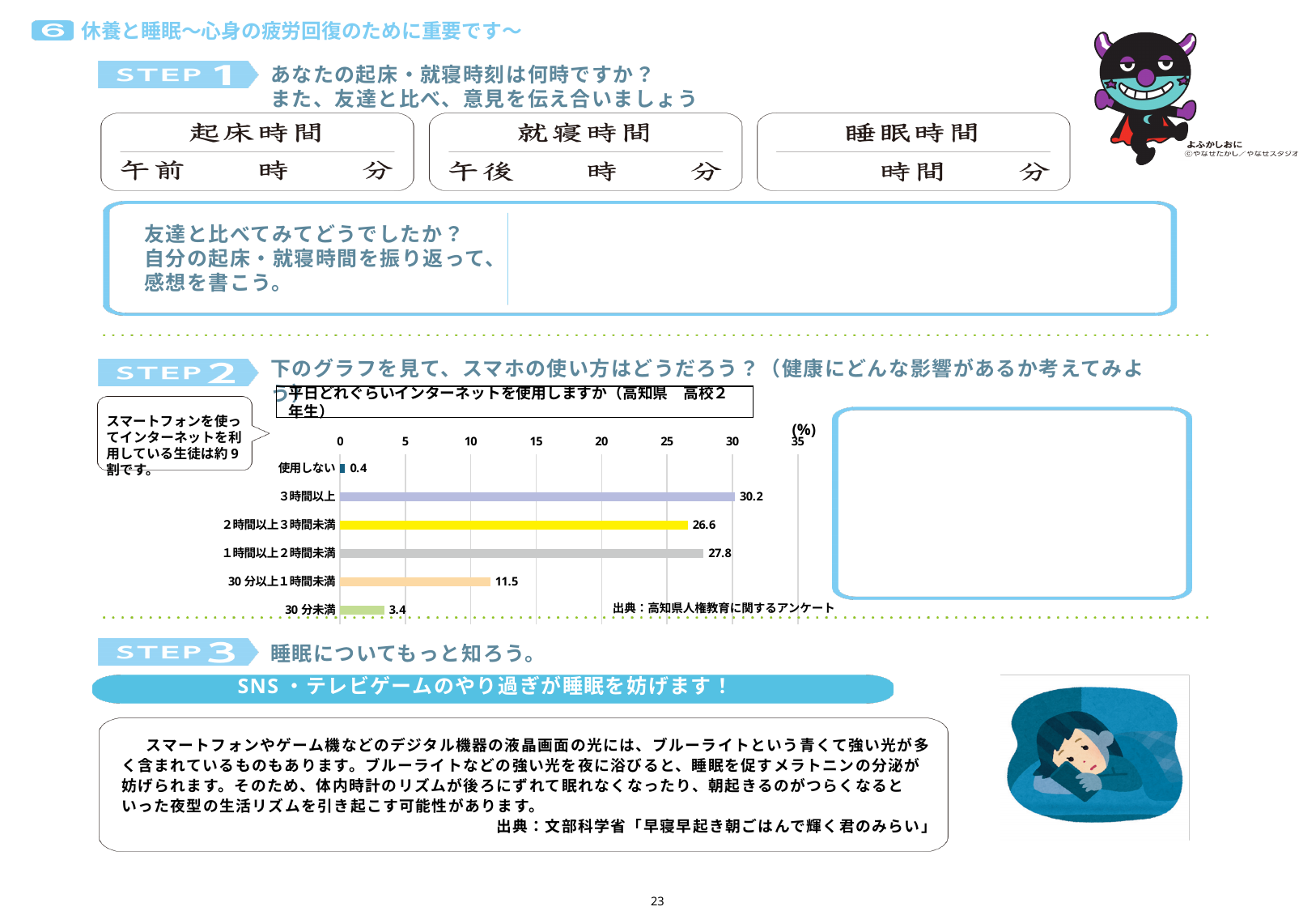
What is the value for 3時間以上 in the chart? 30.2 What is the value for 2時間以上3時間未満 in the chart? 26.6 What is the title of the chart on the slide? 平日どれぐらいインターネットを使用しますか（高知県 高校2年生） What is the difference between the values for 30分以上1時間未満 and 30分未満? 8.1 What is the difference between the values for 3時間以上 and 2時間以上3時間未満? 3.6 What is the value for 30分以上1時間未満 in the chart? 11.5 What is the value for 使用しない in the chart? 0.4 Which category has the lowest value in the chart? 使用しない Which is larger, the value for 1時間以上2時間未満 or the value for 2時間以上3時間未満? 1時間以上2時間未満 What kind of chart is shown on the slide? bar chart Which category has the highest value in the chart? 3時間以上 How many categories are shown in the chart? 6